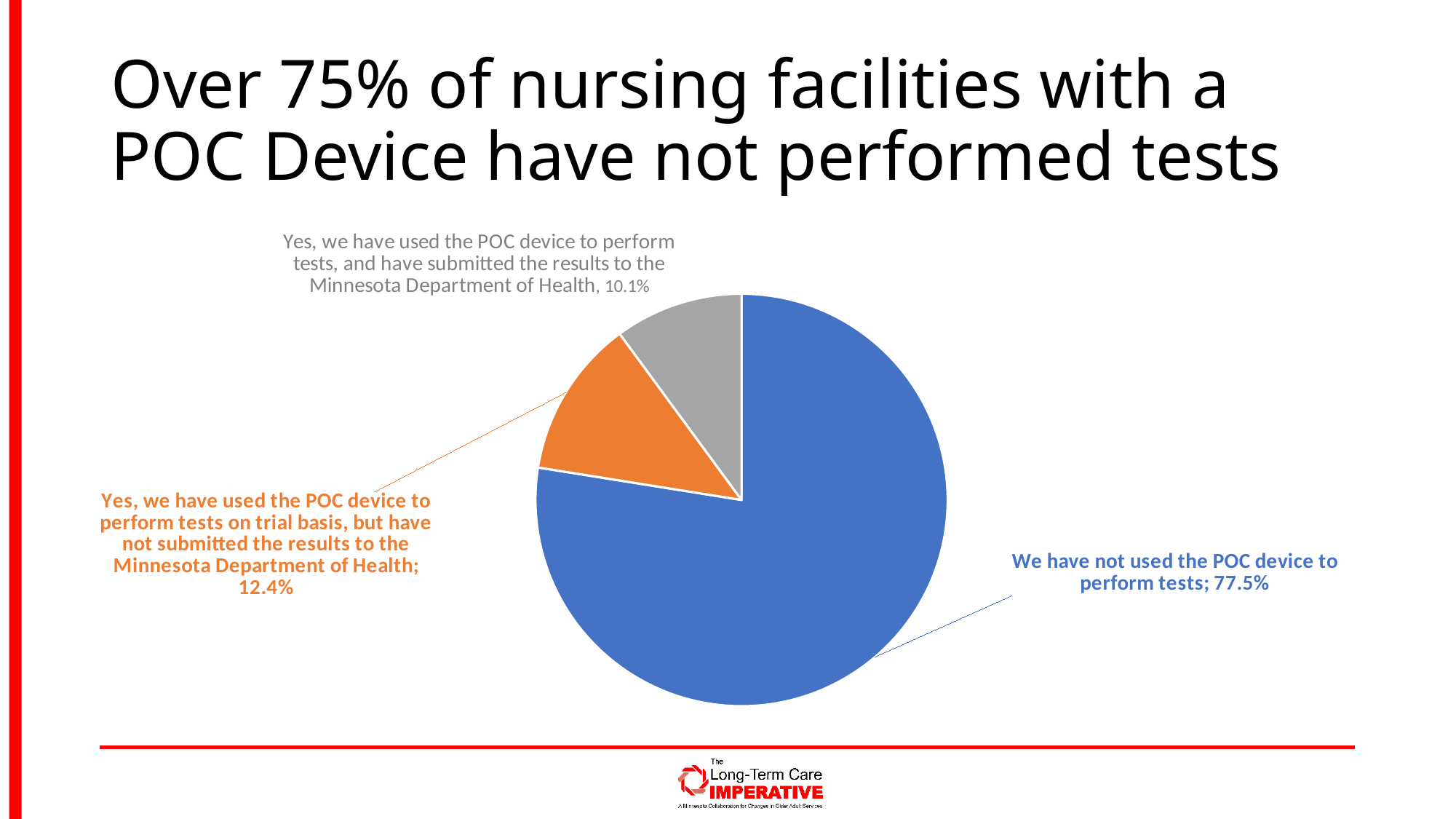
How many slices does the pie chart have? 3 What kind of chart is shown on the slide? pie chart Which category has the largest slice of the pie? We have not used the POC device to perform tests Which is larger: the share that used the device on a trial basis without submitting results, or the share that used it and submitted results? Yes, we have used the POC device to perform tests on trial basis, but have not submitted the results to the Minnesota Department of Health What colour is the slice for facilities that have not used the POC device to perform tests? blue What is the title of the slide containing the pie chart? Over 75% of nursing facilities with a POC Device have not performed tests What share of nursing facilities have not used the POC device to perform tests? 77.5% What share of facilities have used the POC device to perform tests on a trial basis but have not submitted the results to the Minnesota Department of Health? 12.4% Which category has the smallest slice of the pie? Yes, we have used the POC device to perform tests, and have submitted the results to the Minnesota Department of Health What is the combined share of facilities that have used the POC device in any way (trial basis plus submitted results)? 22.5% What share of facilities have used the POC device to perform tests and have submitted the results to the Minnesota Department of Health? 10.1% What is the difference in percentage points between the facilities that have not used the POC device and those that used it on a trial basis without submitting results? 65.1